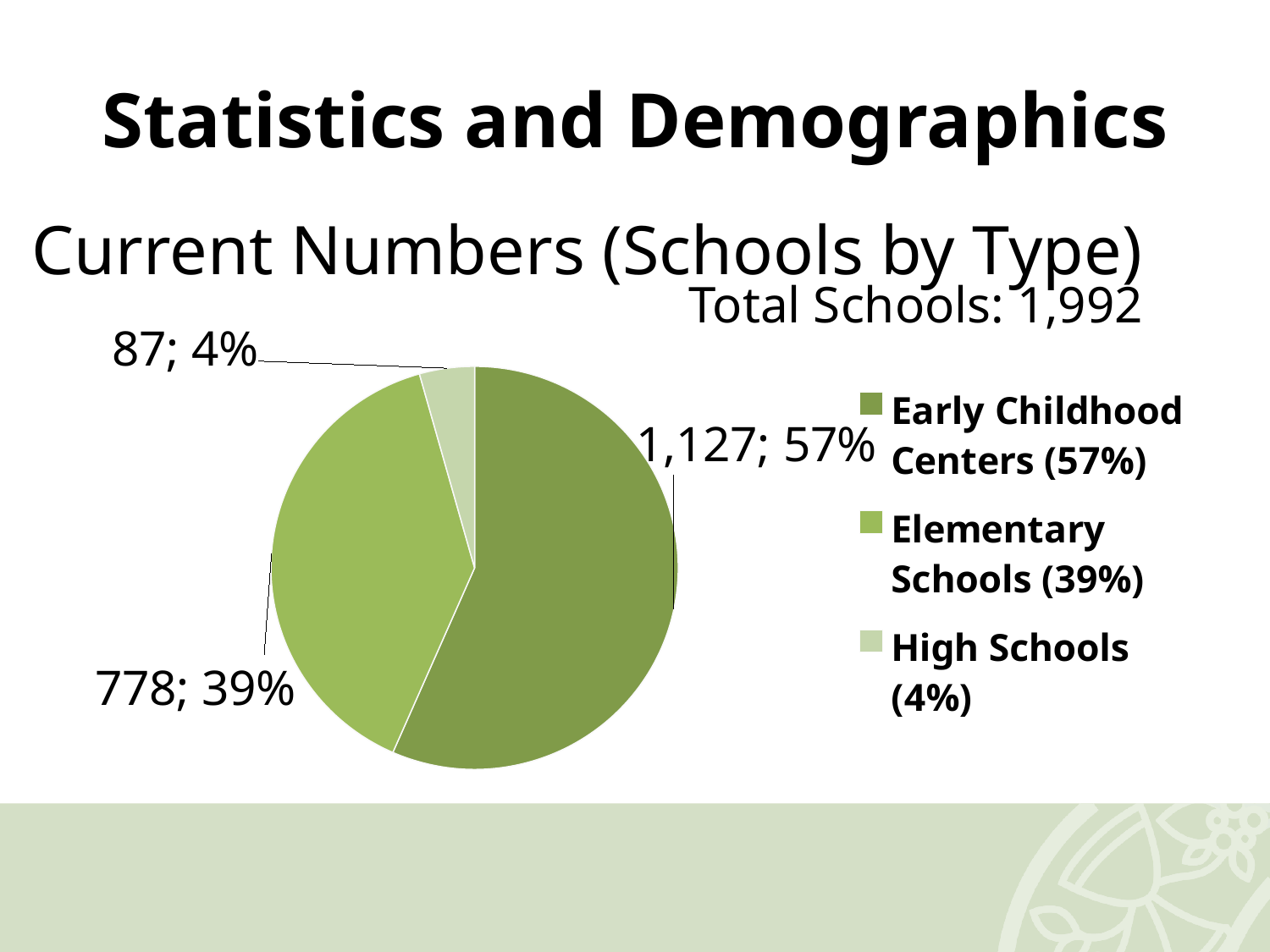
What is the value for Elementary Schools? 778 What is the value for Early Childhood Centers? 1,127 What is the difference between the number of Early Childhood Centers and Elementary Schools? 349 How many slices does the pie chart have? 3 How many entries does the legend list? 3 What is the value for High Schools? 87 What share of the pie do Elementary Schools represent? 39% What total number of schools is stated on the slide? 1,992 What share of the pie do High Schools represent? 4% What kind of chart is shown on the slide? pie chart Which school type has the smallest slice? High Schools Which school type has the largest slice? Early Childhood Centers